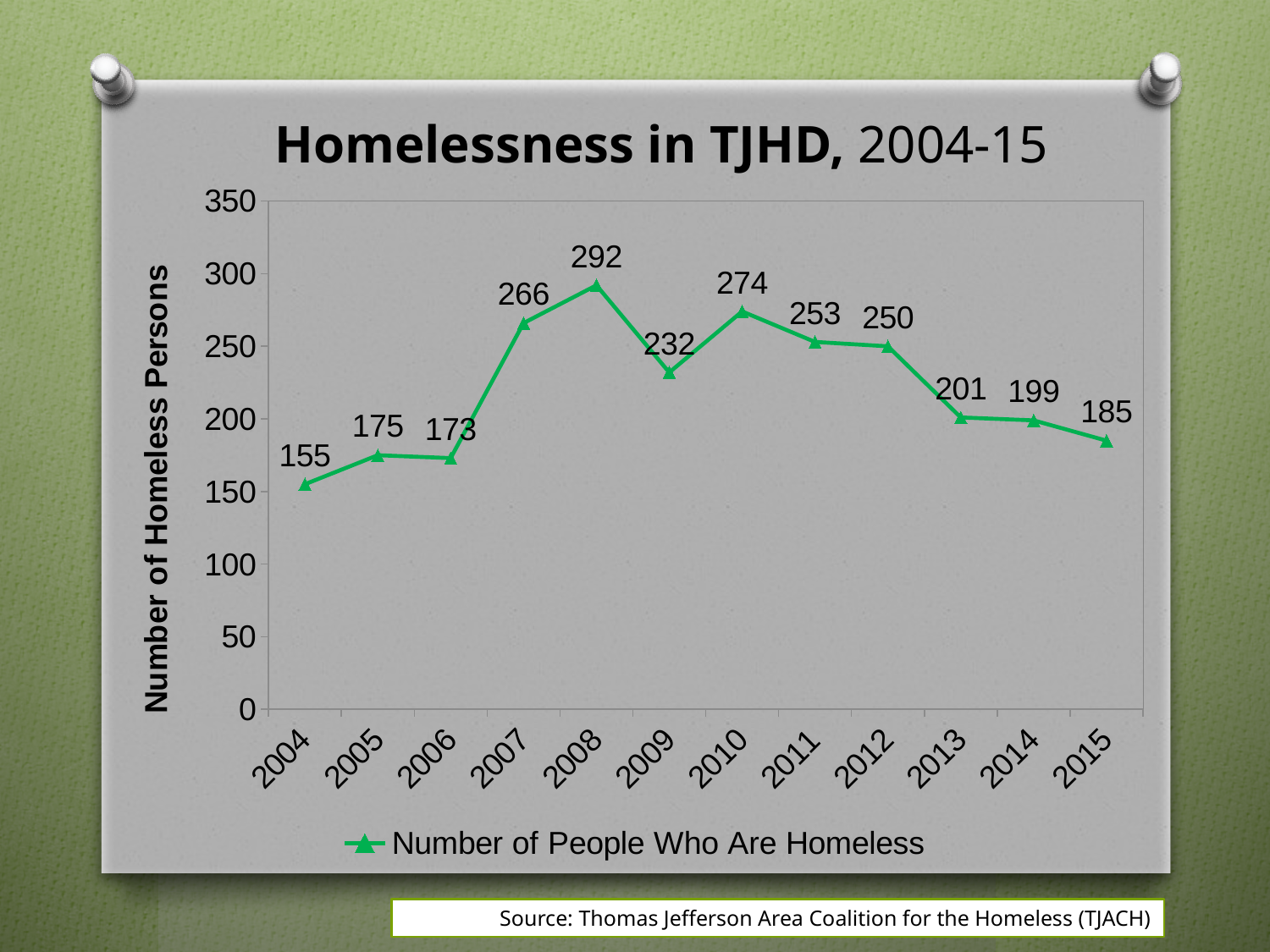
What is the number of homeless persons in 2008? 292 Do the values rise or fall from 2012 to 2015? Fall What is the difference between the number of homeless persons in 2010 and in 2004? 119 What is the difference between the number of homeless persons in 2008 and in 2009? 60 Is the value for 2012 greater or less than 200? greater What is the number of homeless persons in 2004? 155 Which year has the highest number of homeless persons? 2008 Which year has the lowest number of homeless persons? 2004 What is the number of homeless persons in 2015? 185 What kind of chart is shown on the slide? Line chart How many years are plotted on the chart? 12 Which year has a larger number of homeless persons, 2007 or 2011? 2007